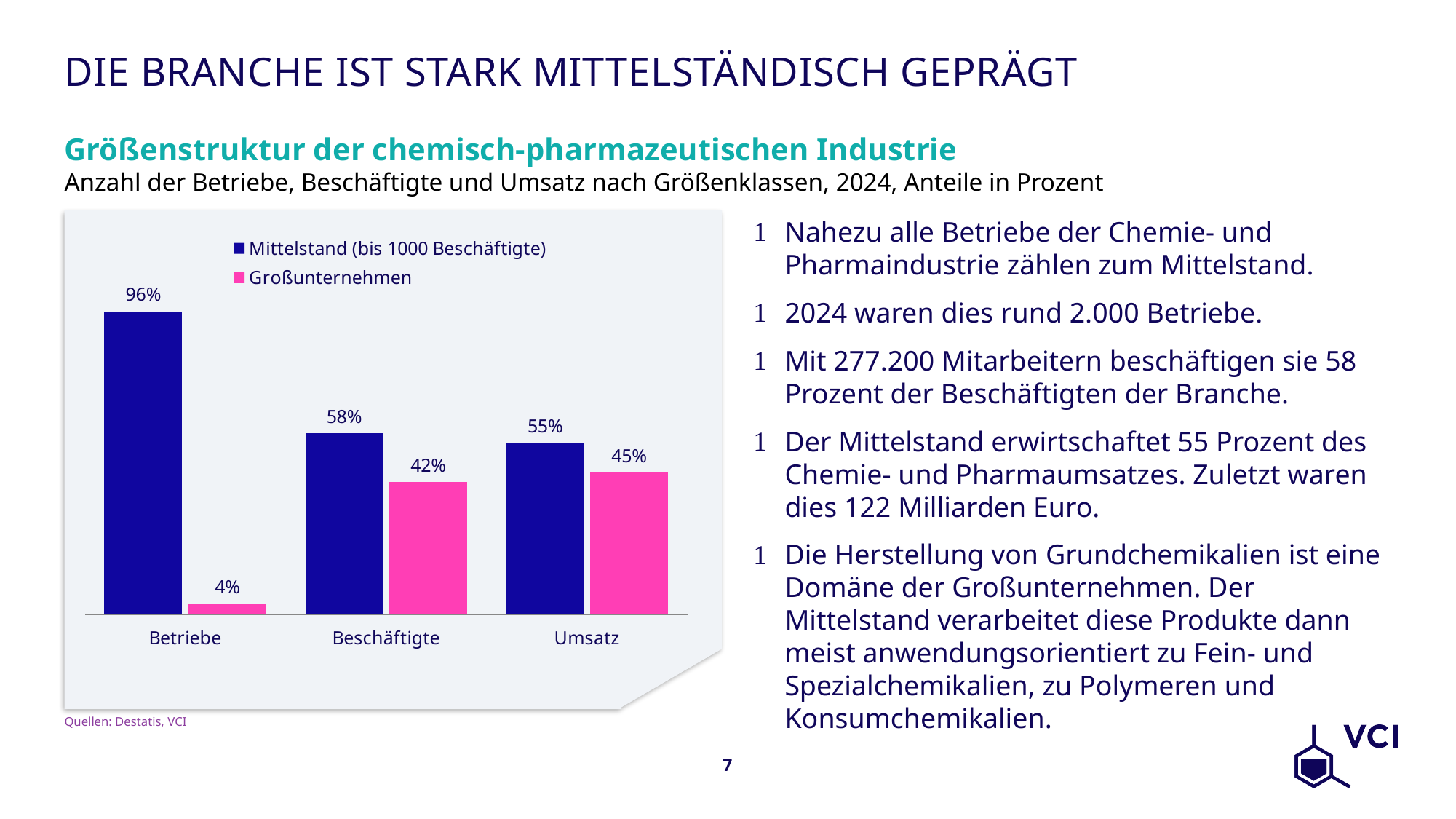
How many categories are shown on the x axis? 3 What kind of chart is shown on the slide? Bar chart What is the Großunternehmen value for Umsatz? 45% For which category is the Mittelstand (bis 1000 Beschäftigte) value highest? Betriebe What is the Großunternehmen value for Betriebe? 4% For which category is the Großunternehmen value lowest? Betriebe Which is larger for Umsatz: Mittelstand (bis 1000 Beschäftigte) or Großunternehmen? Mittelstand (bis 1000 Beschäftigte) What is the Mittelstand (bis 1000 Beschäftigte) value for Beschäftigte? 58% What is the Mittelstand (bis 1000 Beschäftigte) value for Betriebe? 96% What colour are the Großunternehmen bars? Pink What is the difference between the Mittelstand and Großunternehmen values for Beschäftigte? 16% How many series does the legend list? 2